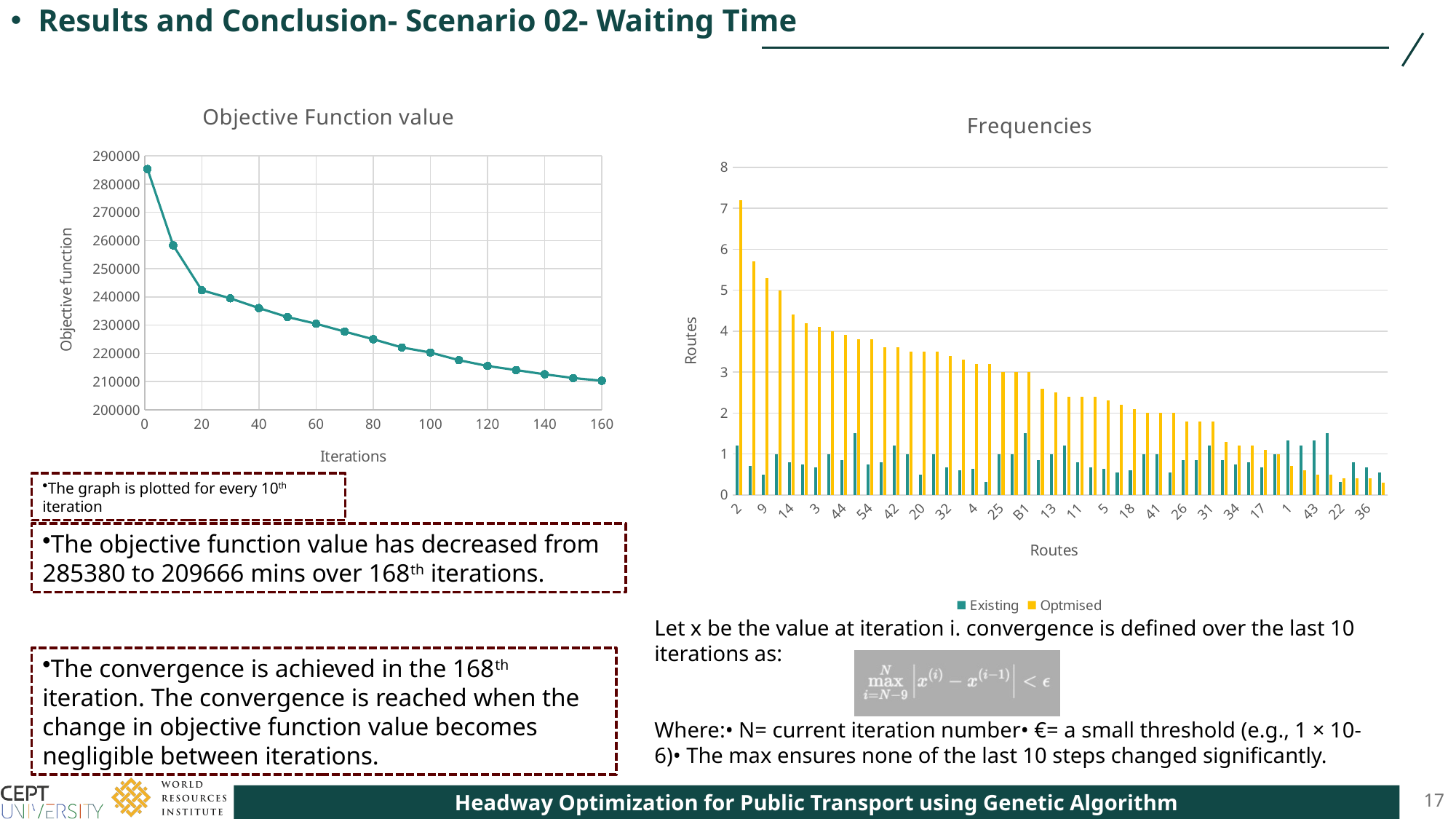
In the "Objective Function value" chart, do the values rise or fall as the iterations increase? fall What is the x-axis label of the "Objective Function value" chart? Iterations In the "Frequencies" chart, which route has the highest Optmised value? 2 What kind of chart is the "Frequencies" chart? bar chart In the "Objective Function value" chart, is the value at iteration 160 greater or less than 220000? less What kind of chart is the "Objective Function value" chart? line chart In the "Frequencies" chart, which colour represents the Existing series? teal In the "Frequencies" chart, is the Optmised value for route 2 greater or less than 7? greater In the "Objective Function value" chart, is the value at iteration 0 greater or less than 280000? greater How many series does the legend of the "Frequencies" chart list? 2 How many data points are plotted in the "Objective Function value" chart? 17 In the "Frequencies" chart, for route 2, which is larger: the Existing value or the Optmised value? Optmised